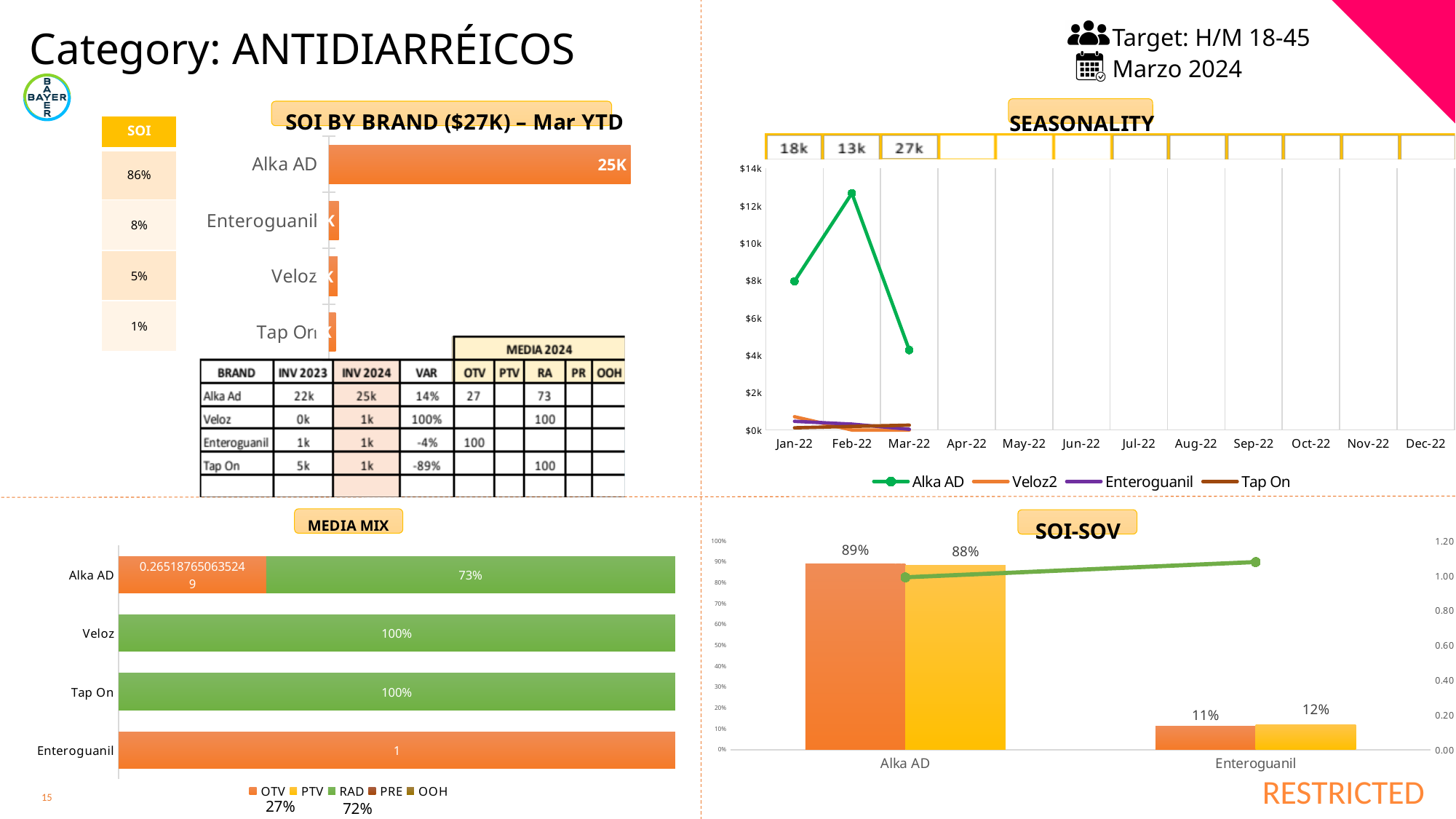
In the SOI-SOV chart, what is the value of the orange bar for Enteroguanil? 11% How many months are shown on the x axis of the SEASONALITY chart? 12 In the SOI BY BRAND chart, what is the value shown for Alka AD? 25K What kind of chart is the SOI BY BRAND chart? Bar chart In the SOI BY BRAND chart, which brand has the highest value? Alka AD In the MEDIA MIX chart, what is the RAD share shown for Alka AD? 73% How many series does the legend of the MEDIA MIX chart list? 5 In the SEASONALITY chart, is the Alka AD value for Mar-22 greater or less than $6k? less In the SEASONALITY chart, is the Alka AD value for Feb-22 greater or less than $12k? greater How many series does the legend of the SEASONALITY chart list? 4 In the SEASONALITY chart, in which month does the Alka AD line reach its highest point? Feb-22 In the SOI-SOV chart, what is the difference between the orange bar values for Alka AD and Enteroguanil? 78%